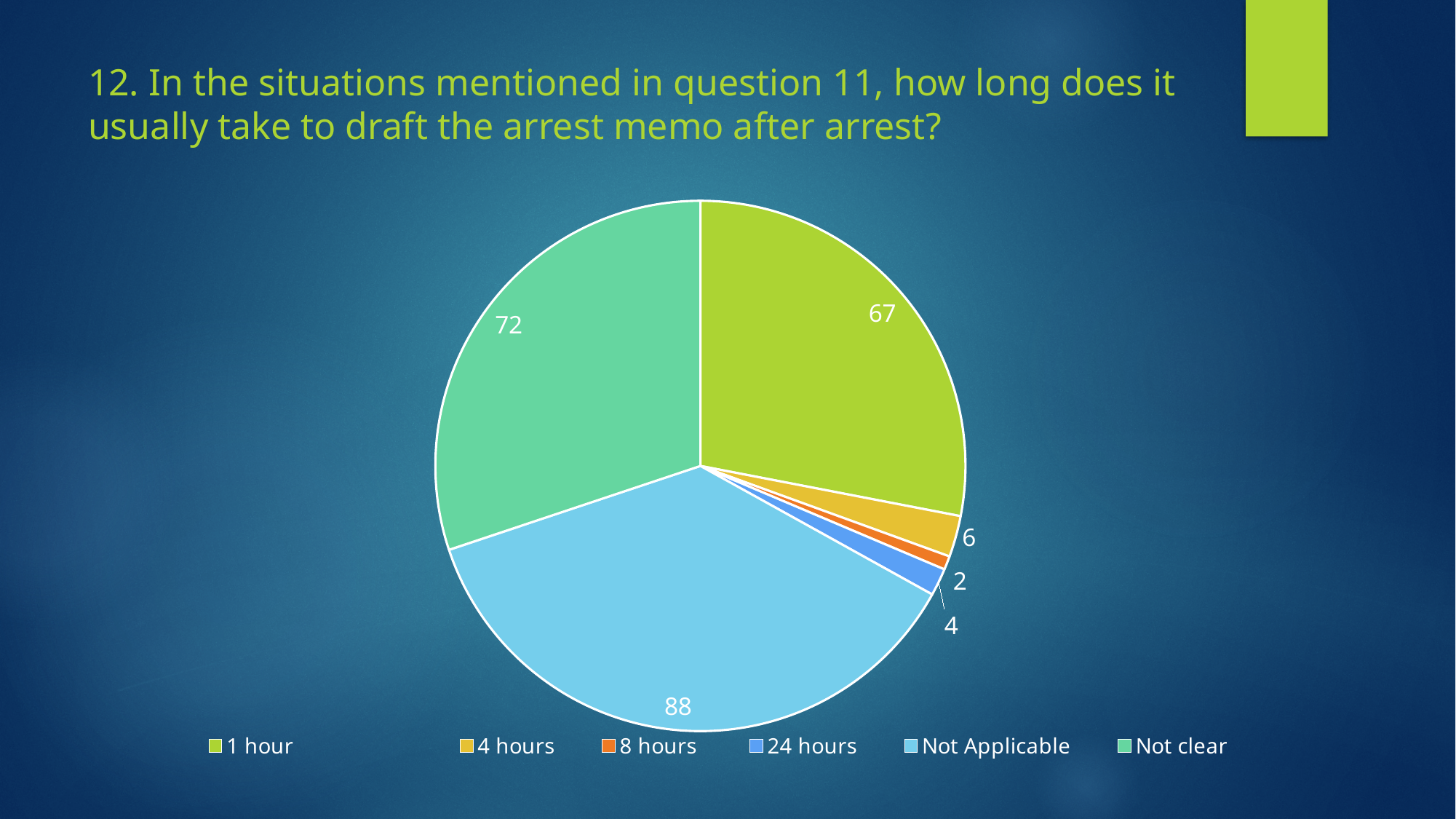
What is the value for the "Not Applicable" slice? 88 What is the difference between the "Not Applicable" and "Not clear" values? 16 What is the value for the "24 hours" slice? 4 Which is larger, the value for "1 hour" or the value for "Not clear"? Not clear Which category has the smallest slice? 8 hours What colour is the "4 hours" slice? yellow What is the total of all the slice values? 239 How many categories does the legend list? 6 What is the value for the "1 hour" slice? 67 What type of chart is shown on the slide? pie chart Which category has the largest slice? Not Applicable What is the value for the "Not clear" slice? 72